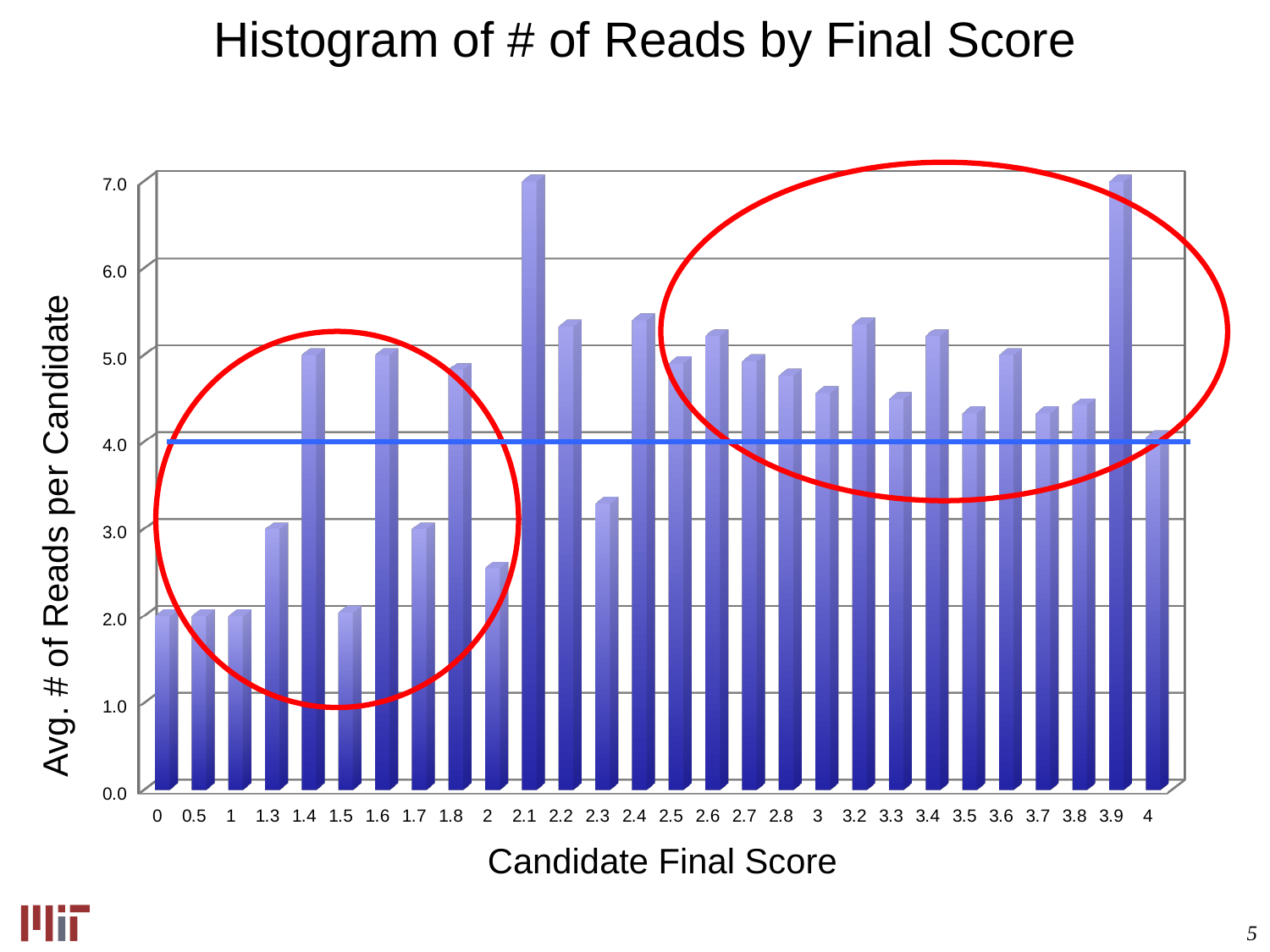
What is the label of the y axis? Avg. # of Reads per Candidate What kind of chart is shown on the slide? bar chart Is the value for candidate final score 2.3 greater or less than 4.0? less Which has the larger value, candidate final score 2.1 or 2.3? 2.1 Is the value for candidate final score 2 greater or less than 3.0? less What is the title of the chart? Histogram of # of Reads by Final Score Is the value for candidate final score 3.5 greater or less than 4.0? greater Which has the larger value, candidate final score 1.3 or 1.4? 1.4 Do the values generally rise or fall as the candidate final score increases from 0 to 4? rise How many candidate final score categories are shown on the x axis? 28